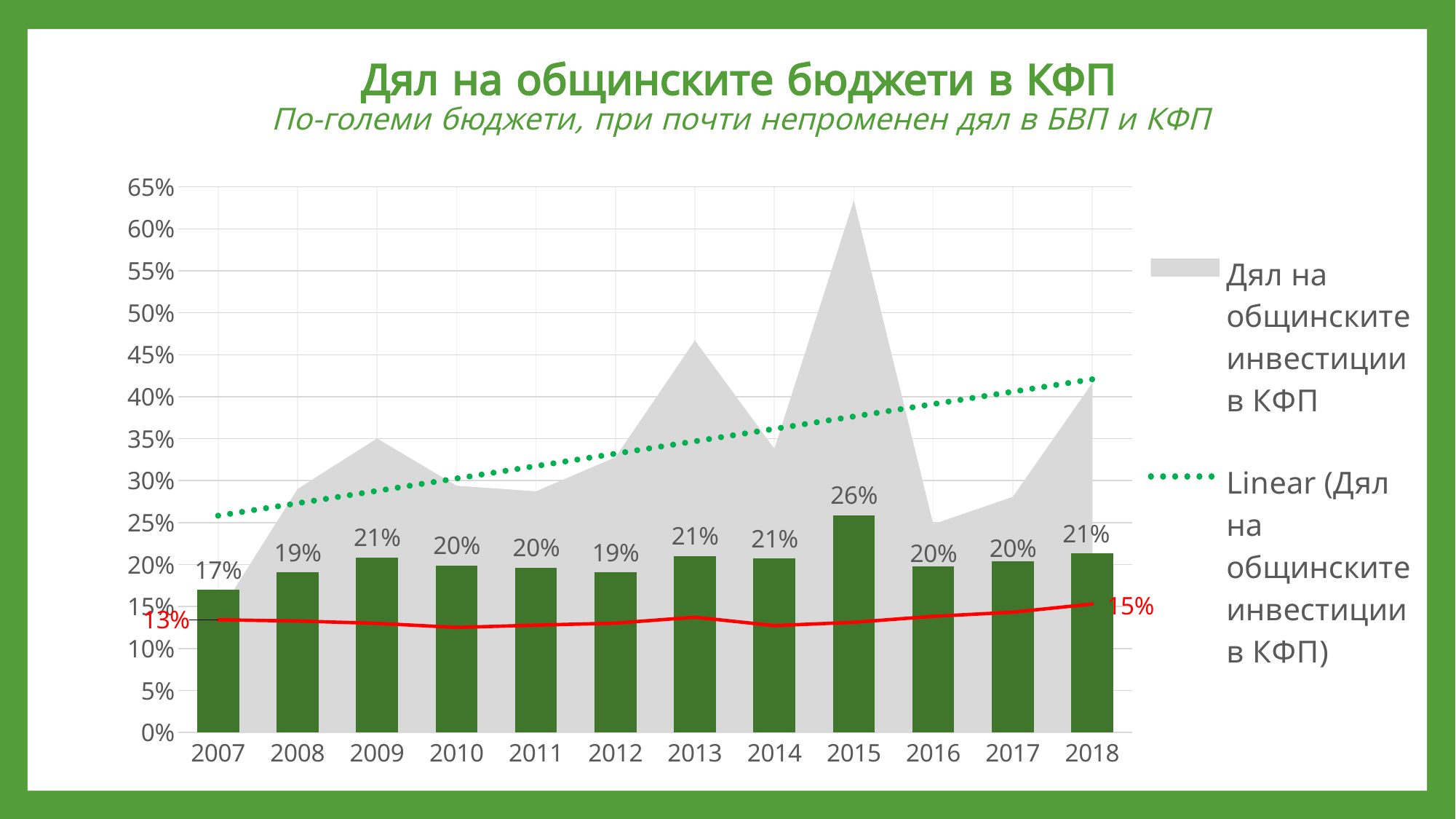
What is the value shown on the green bar for 2015? 26% What is the difference between the green bar values for 2015 and 2007? 9% Which green bar is taller, 2009 or 2012? 2009 What value does the red line show for 2018? 15% What is the value shown on the green bar for 2007? 17% How many series does the legend list? 2 Is the value of the grey area series (Дял на общинските инвестиции в КФП) for 2015 greater or less than 55%? greater Which year has the lowest green bar? 2007 Does the red line rise or fall from 2007 to 2018? rise What value does the red line show for 2007? 13% Which year has the highest green bar? 2015 How many years are shown on the x axis? 12